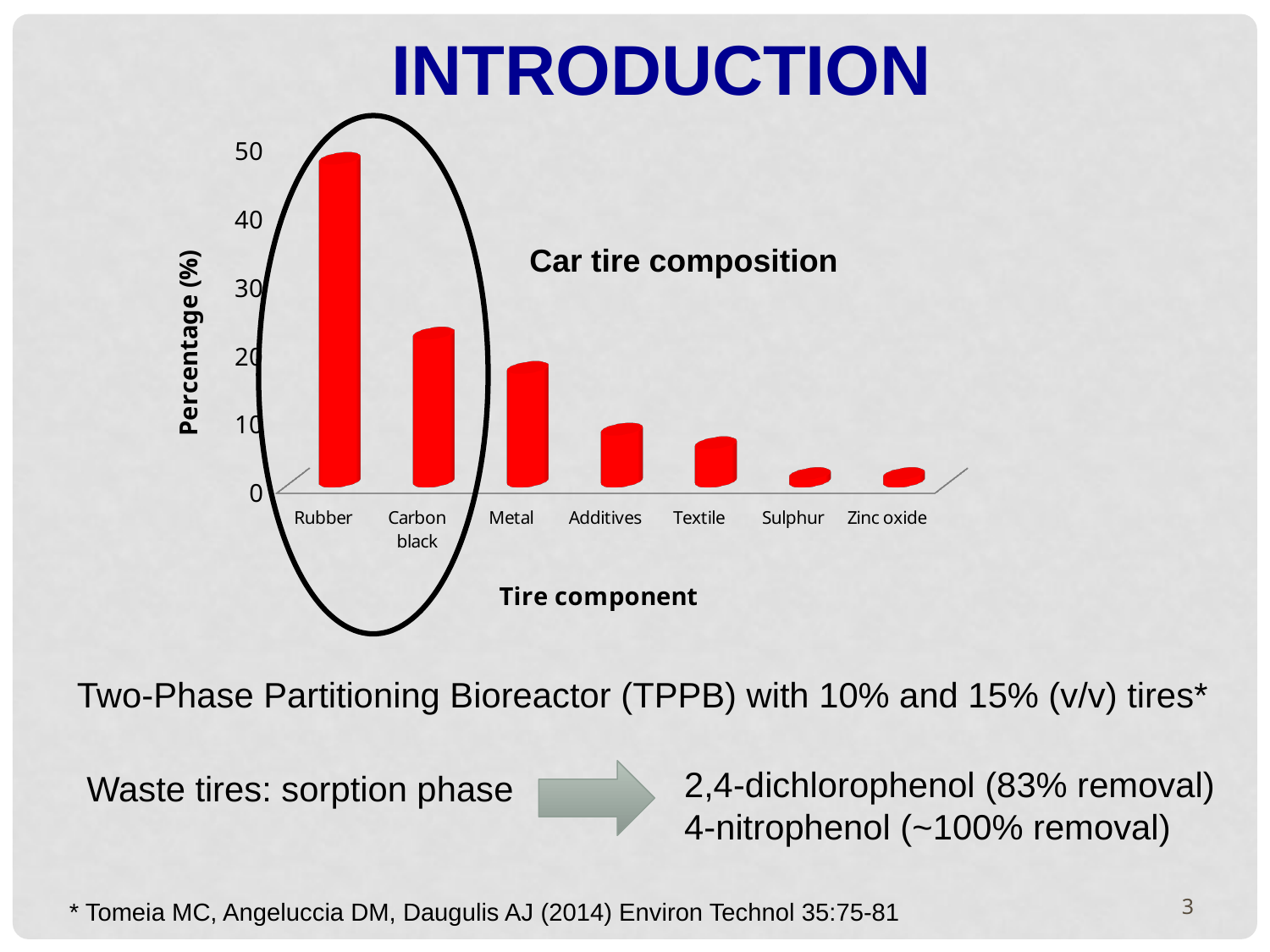
What is the title of the chart? Car tire composition Is the value for Carbon black greater or less than 20? greater Which tire component has the highest percentage in the chart? Rubber Is the value for Rubber greater or less than 40? greater Which is larger, the value for Rubber or the value for Carbon black? Rubber What is the label of the y axis of the chart? Percentage (%) What kind of chart is shown on the slide? bar chart Is the value for Additives greater or less than 10? less Do the values rise or fall moving from Rubber to Textile along the x axis? fall How many tire components are shown on the x axis of the chart? 7